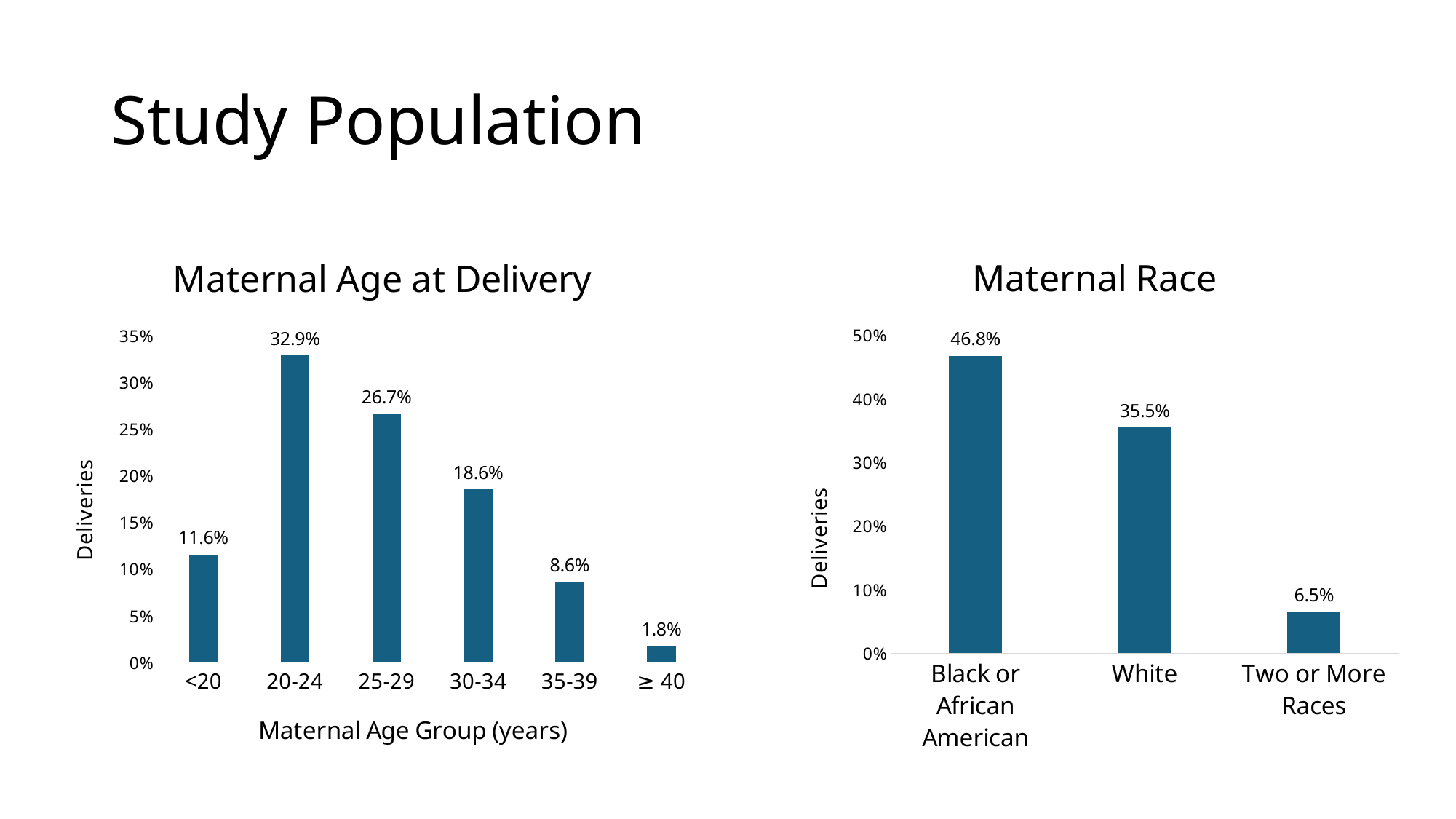
In the Maternal Age at Delivery chart, do the values rise or fall from the 20-24 group to the ≥ 40 group? fall In the Maternal Age at Delivery chart, what is the difference between the 25-29 and 30-34 age groups? 8.1% In the Maternal Race chart, which category has the highest share of deliveries? Black or African American In the Maternal Race chart, what percentage of deliveries were to White mothers? 35.5% In the Maternal Age at Delivery chart, how many age groups are shown? 6 What kind of chart is the Maternal Race chart? bar chart In the Maternal Age at Delivery chart, what is the value for the <20 age group? 11.6% In the Maternal Race chart, is the value for Two or More Races greater or less than 10%? less In the Maternal Race chart, what is the difference between Black or African American and White? 11.3% In the Maternal Age at Delivery chart, which age group has the lowest share of deliveries? ≥ 40 In the Maternal Age at Delivery chart, which age group has the highest share of deliveries? 20-24 In the Maternal Age at Delivery chart, what percentage of deliveries were to mothers aged 20-24? 32.9%